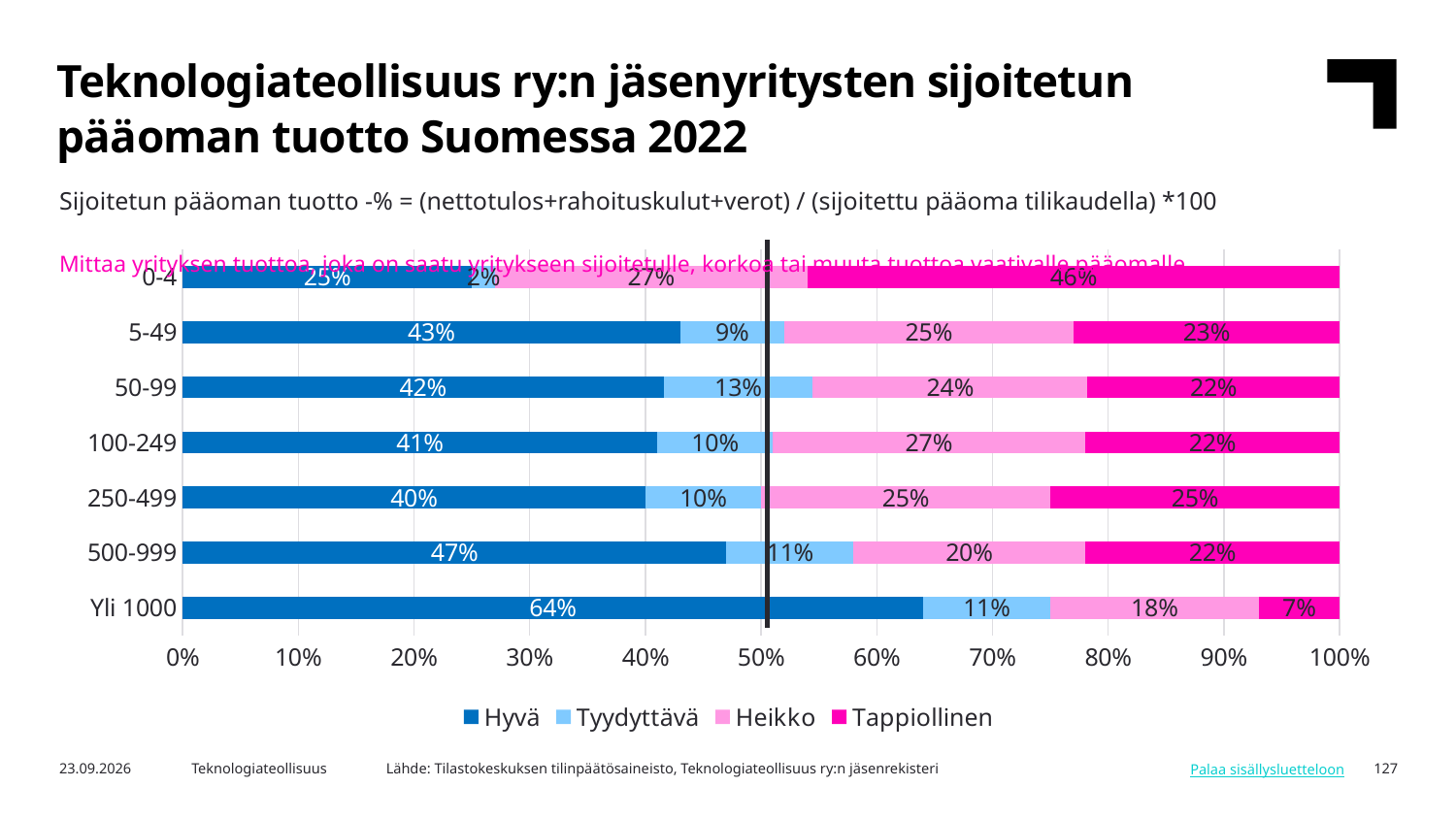
How many size classes are shown on the chart? 7 What is the Tyydyttävä share for the 50-99 size class? 13% What is the Heikko share for the 500-999 size class? 20% Which is larger: the Heikko share for 100-249 or the Heikko share for 250-499? 100-249 How many series does the legend list? 4 What is the Tappiollinen share for the 5-49 size class? 23% What is the Hyvä share for the Yli 1000 size class? 64% Which size class has the lowest Tappiollinen share? Yli 1000 What kind of chart is shown on the slide? Stacked bar chart Which size class has the highest Tappiollinen share? 0-4 Which size class has the highest Hyvä share? Yli 1000 What is the difference between the Hyvä share of Yli 1000 and the Hyvä share of 500-999? 17 percentage points